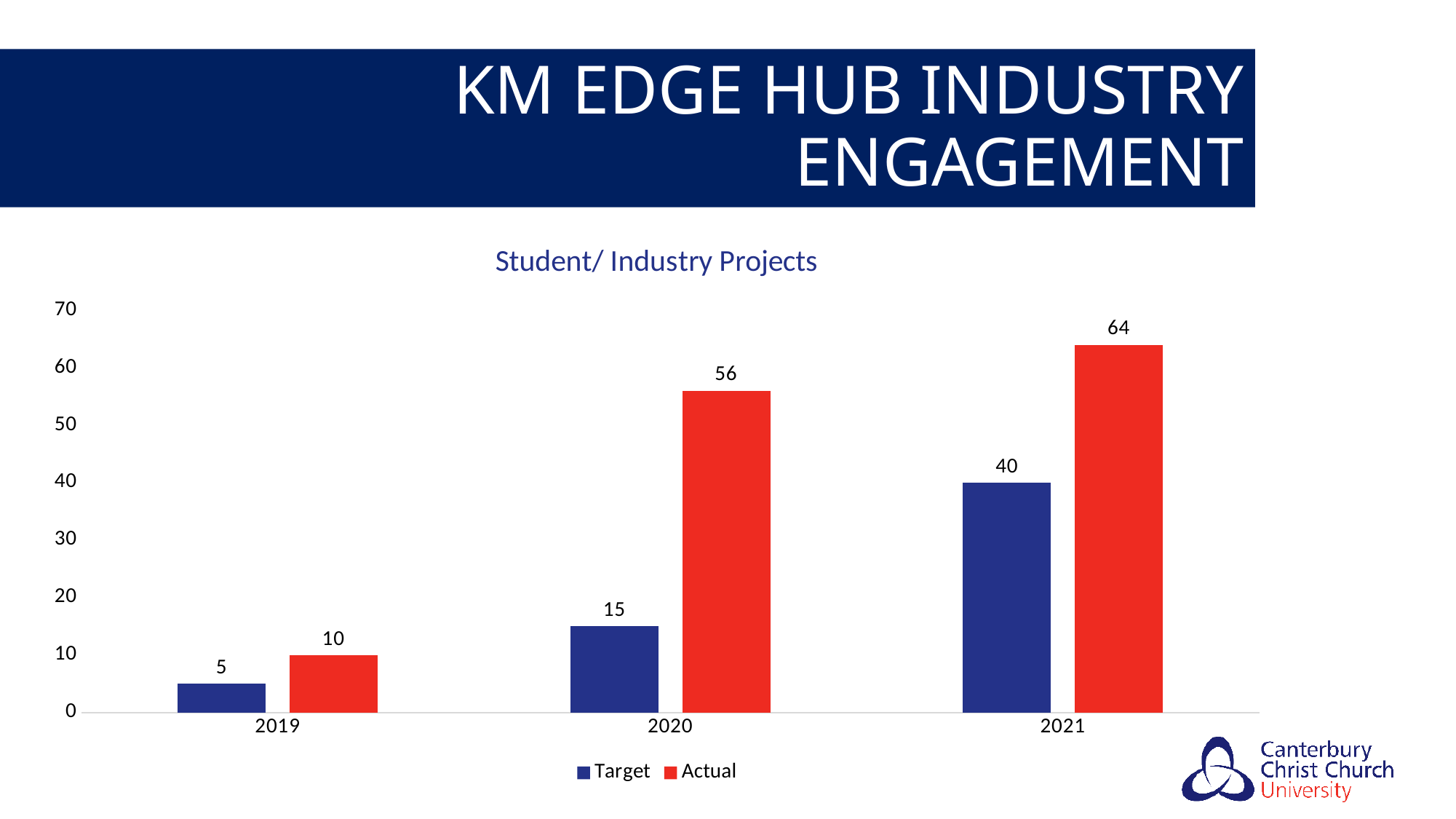
What is the Target value for 2020? 15 What is the Actual value for 2019? 10 Which year has the lowest Target value? 2019 Which is larger for 2021, the Target or the Actual value? Actual Do the Actual values rise or fall from 2019 to 2021? Rise How many years are shown on the x axis? 3 What kind of chart is shown? Bar chart How many series does the legend list? 2 What is the title of the chart? Student/ Industry Projects Which year has the highest Actual value? 2021 What is the Actual value for 2021? 64 What is the difference between the Actual and Target values for 2020? 41